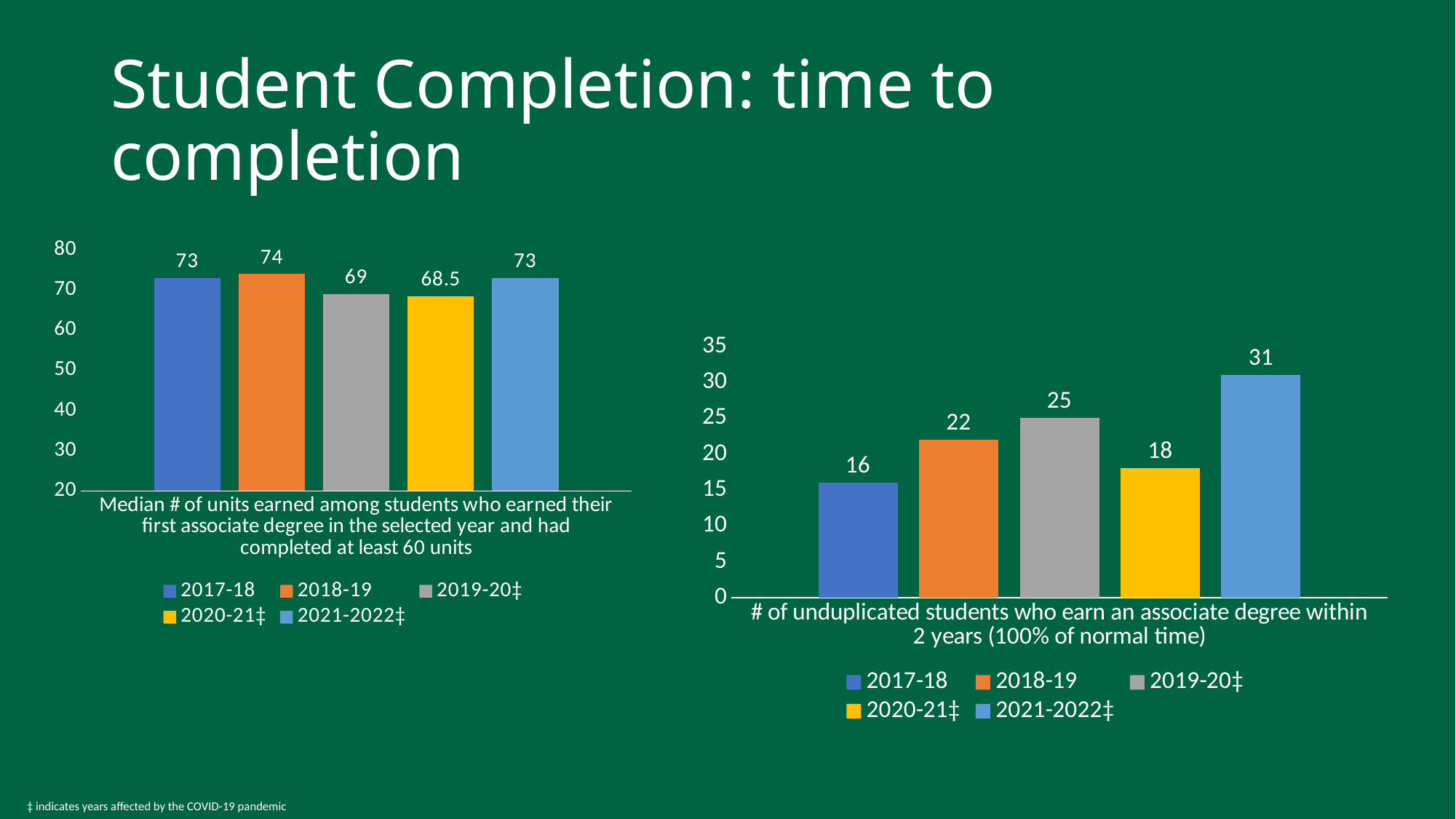
In the left chart (median # of units earned), what is the value for 2018-19? 74 In the left chart (median # of units earned), which year has the lowest value? 2020-21‡ In the right chart (# of unduplicated students who earn an associate degree within 2 years), what colour is the bar for 2020-21‡? yellow In the left chart (median # of units earned), what is the value for 2020-21‡? 68.5 In the right chart (# of unduplicated students who earn an associate degree within 2 years), what is the value for 2019-20‡? 25 In the right chart (# of unduplicated students who earn an associate degree within 2 years), what is the difference between the 2021-2022‡ value and the 2017-18 value? 15 In the right chart (# of unduplicated students who earn an associate degree within 2 years), which year has the lowest value? 2017-18 In the right chart (# of unduplicated students who earn an associate degree within 2 years), which is larger, the value for 2018-19 or the value for 2020-21‡? 2018-19 In the left chart (median # of units earned), what is the difference between the 2018-19 value and the 2019-20‡ value? 5 In the left chart (median # of units earned), how many series does the legend list? 5 What kind of chart is the right chart (# of unduplicated students who earn an associate degree within 2 years)? bar chart In the right chart (# of unduplicated students who earn an associate degree within 2 years), which year has the highest value? 2021-2022‡